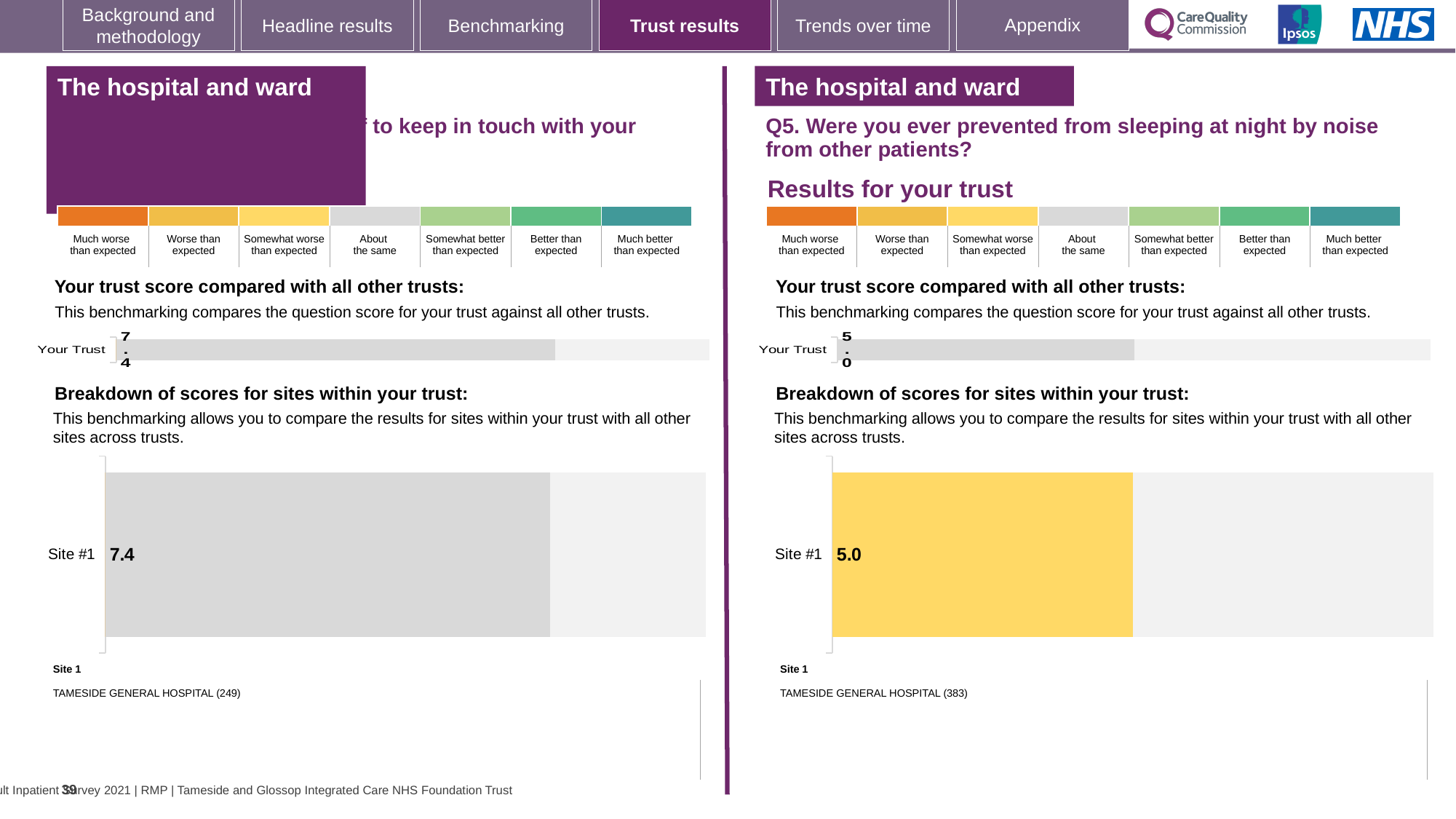
On the right-hand chart for Q5 (prevented from sleeping at night by noise from other patients), what is the score shown for Your Trust? 5.0 What type of chart is used for the 'Breakdown of scores for sites within your trust' on the right-hand side? Bar chart On the left-hand 'Breakdown of scores for sites within your trust' chart, what is the score for Site #1? 7.4 Which is larger: the Site #1 score on the left-hand breakdown chart or the Site #1 score on the right-hand breakdown chart? Left-hand (7.4) Which site name is listed as Site 1 beneath the left-hand breakdown chart? TAMESIDE GENERAL HOSPITAL (249) On the right-hand breakdown chart, what colour is the Site #1 bar? Yellow On the right-hand 'Breakdown of scores for sites within your trust' chart, what is the score for Site #1? 5.0 How many sites are shown on the right-hand 'Breakdown of scores for sites within your trust' chart? 1 What is the difference between the Site #1 score on the left-hand breakdown chart (7.4) and the Site #1 score on the right-hand breakdown chart (5.0)? 2.4 According to the colour key on the right-hand side, which category does the yellow colour of the Site #1 bar represent? Somewhat worse than expected Which site name is listed as Site 1 beneath the right-hand breakdown chart? TAMESIDE GENERAL HOSPITAL (383) On the left-hand 'Your trust score compared with all other trusts' chart, what is the score shown for Your Trust? 7.4